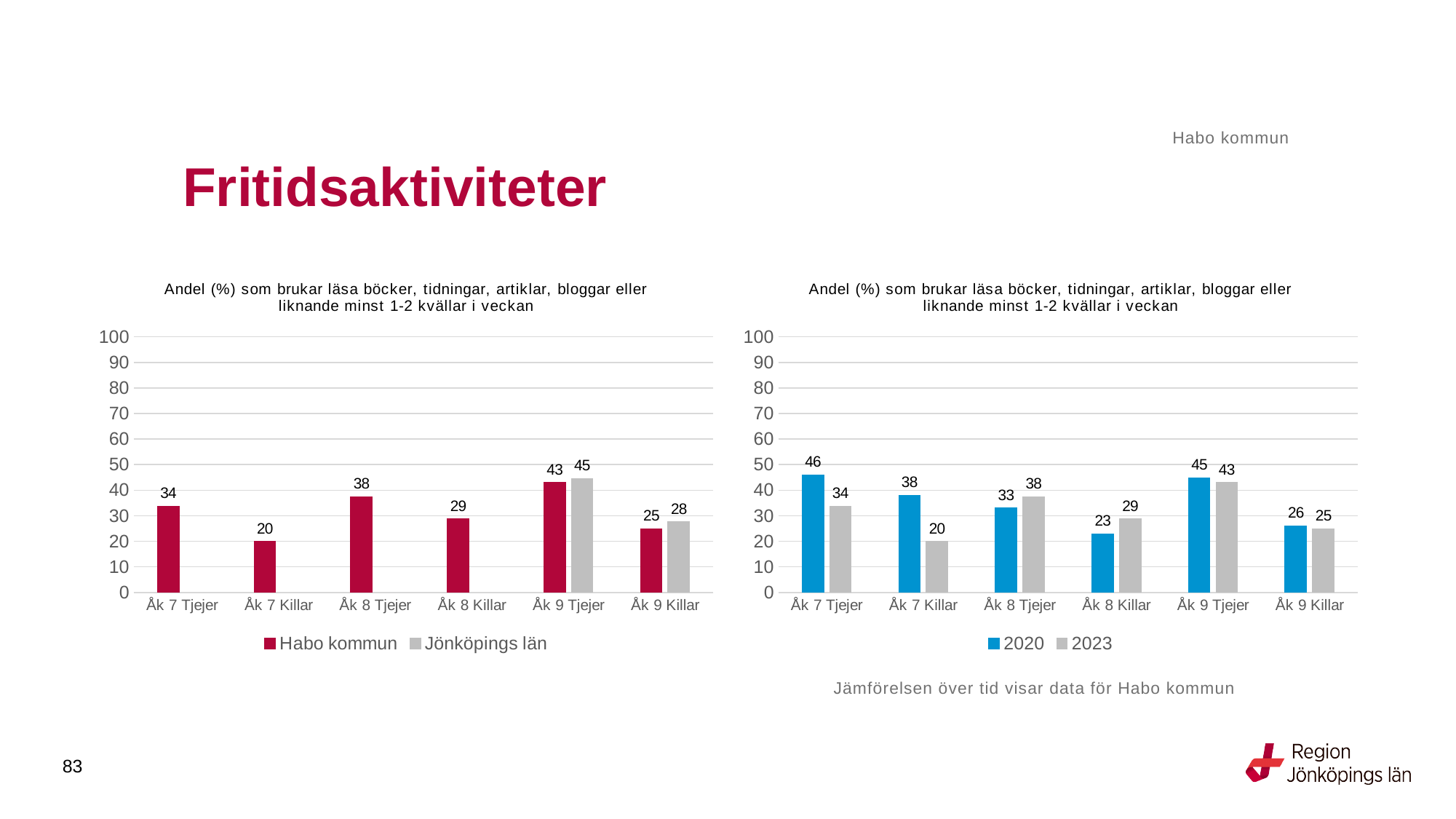
In the right chart, what is the difference between 2020 and 2023 for Åk 7 Killar? 18 In the right chart, which category has the highest value for 2020? Åk 7 Tjejer In the left chart, what is the difference between Jönköpings län and Habo kommun for Åk 9 Killar? 3 In the right chart, which is larger for Åk 9 Tjejer: 2020 or 2023? 2020 In the right chart, what is the value for 2023 for Åk 8 Tjejer? 38 In the right chart, what is the value for 2020 for Åk 8 Killar? 23 In the left chart, how many series does the legend list? 2 In the left chart, which category has the highest value for Habo kommun? Åk 9 Tjejer In the left chart, what is the value for Jönköpings län for Åk 9 Tjejer? 45 What kind of chart is the right chart? Bar chart In the left chart, what is the value for Habo kommun for Åk 7 Tjejer? 34 In the left chart, which category has the lowest value for Habo kommun? Åk 7 Killar